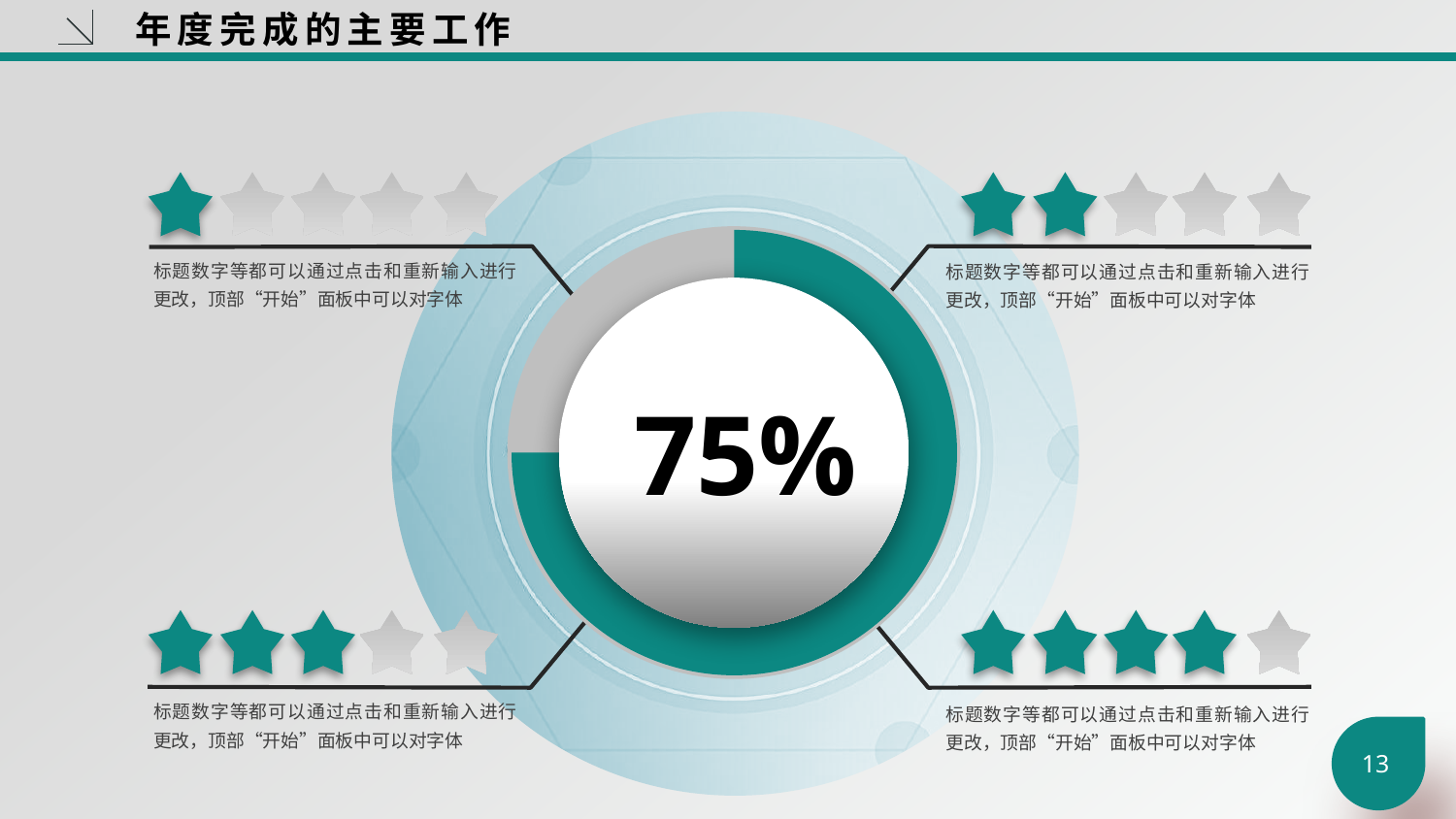
What is the title of the slide containing the donut chart? 年度完成的主要工作 Which segment of the donut chart is larger, the teal one or the grey one? The teal one Is the value shown in the donut chart greater or less than 50%? greater What percentage is printed in the centre of the donut chart? 75% What share of the donut chart does the teal segment represent? 75% What share of the donut chart does the grey segment represent? 25% What colour is the filled (completed) portion of the donut chart? Teal What kind of chart is shown in the centre of the slide? Donut (pie) chart How many segments does the donut chart have? 2